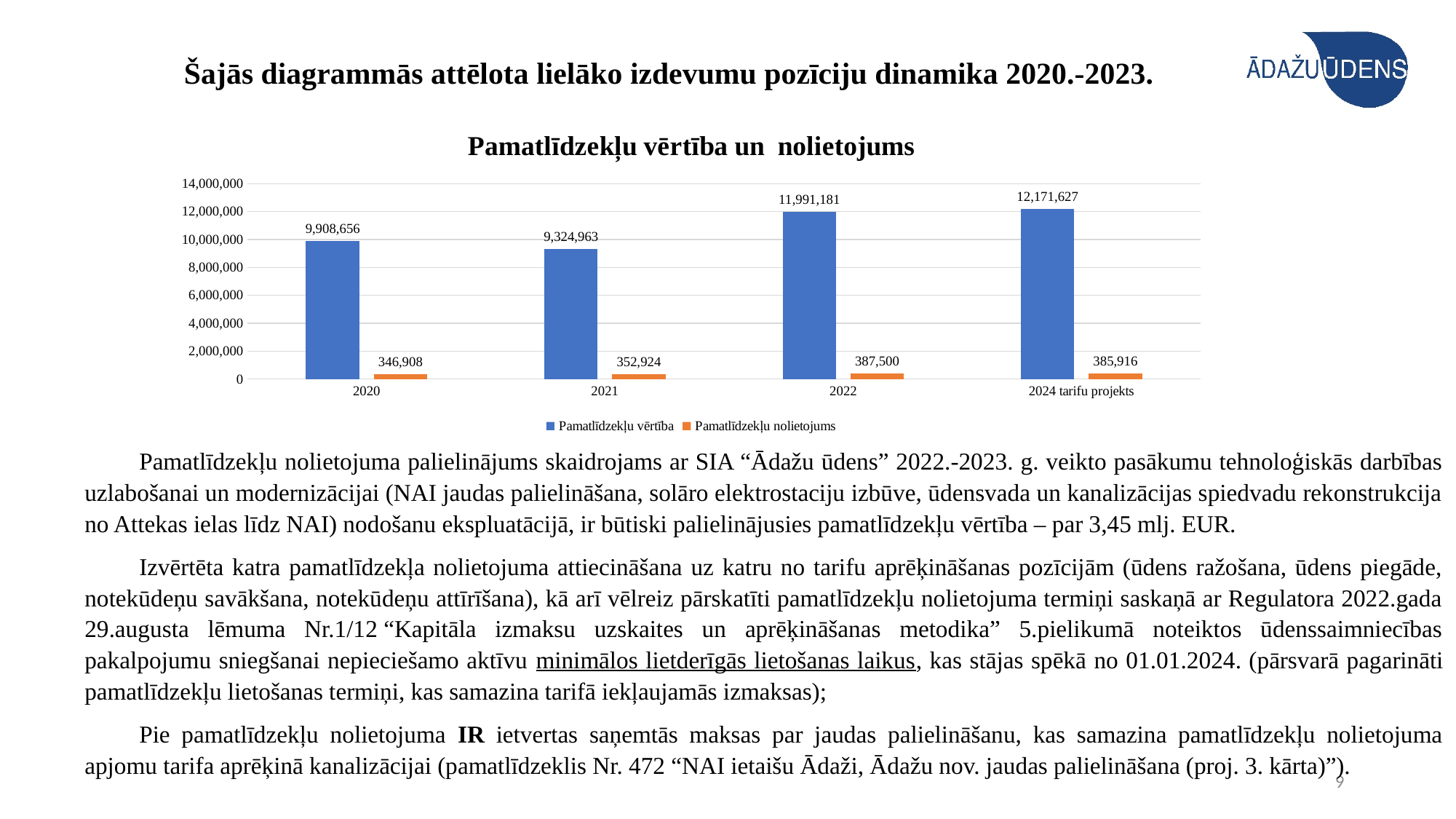
Which is larger, the Pamatlīdzekļu vērtība for 2020 or for 2021? 2020 What is the Pamatlīdzekļu vērtība value for 2020? 9,908,656 Which category has the lowest Pamatlīdzekļu vērtība? 2021 What is the Pamatlīdzekļu nolietojums value for 2022? 387,500 What type of chart is shown on the slide? bar chart How many series does the legend list? 2 What is the difference in Pamatlīdzekļu vērtība between 2024 tarifu projekts and 2022? 180,446 What is the Pamatlīdzekļu nolietojums value for 2021? 352,924 What is the Pamatlīdzekļu vērtība value for 2024 tarifu projekts? 12,171,627 Is the Pamatlīdzekļu vērtība for 2022 greater or less than 10,000,000? greater Which category has the lowest Pamatlīdzekļu nolietojums? 2020 Which category has the highest Pamatlīdzekļu vērtība? 2024 tarifu projekts